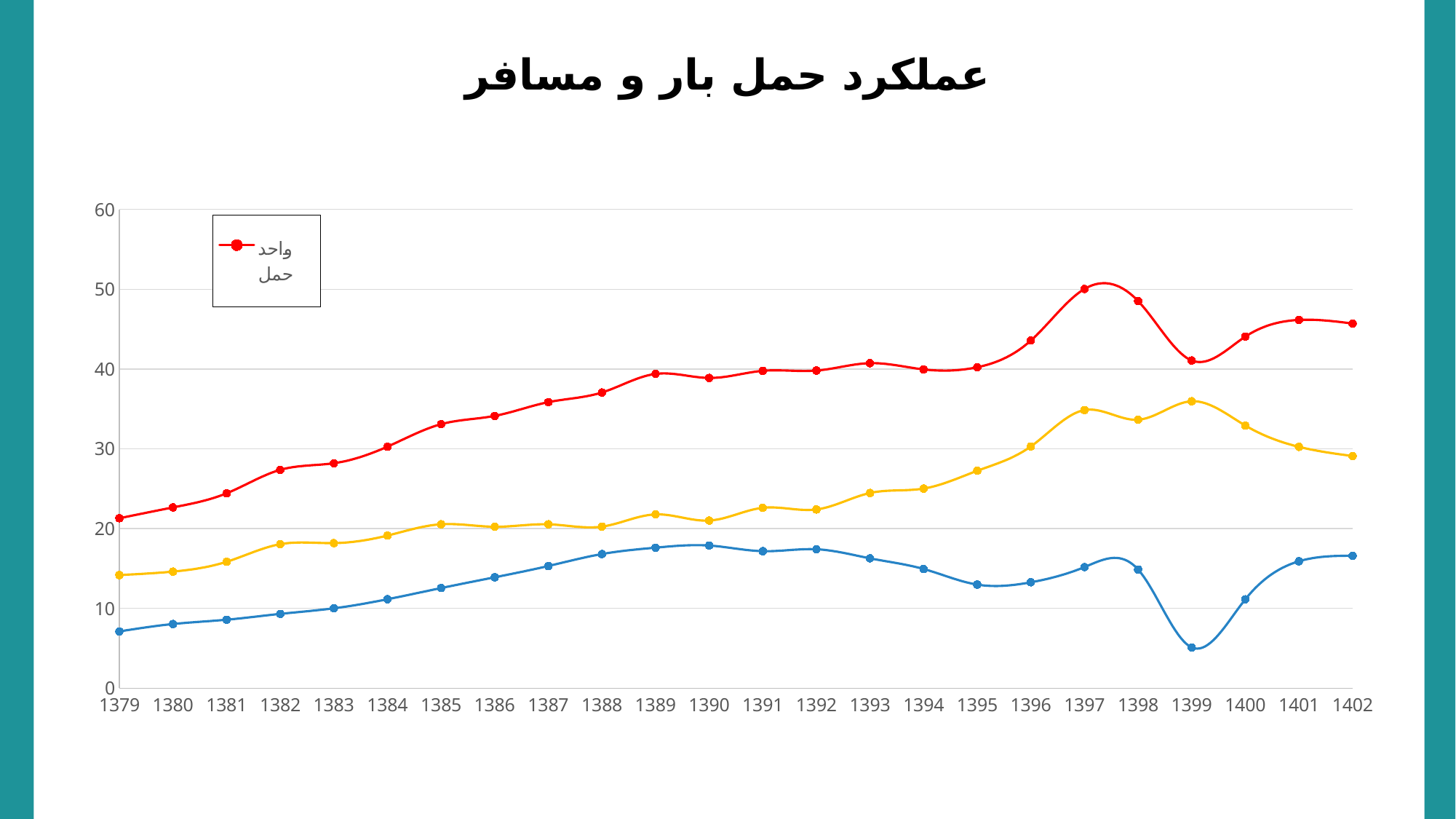
What is the title of the chart? عملکرد حمل بار و مسافر Is the value of the red series (واحد حمل) in 1397 greater or less than 40? greater Is the value of the blue series in 1399 greater or less than 10? less How many years are shown along the x axis? 24 In 1399, which series has the larger value, the red series or the blue series? red series In which year does the red series (واحد حمل) reach its highest value? 1397 How many series does the legend list? 1 Is the value of the yellow series in 1399 greater or less than 30? greater In which year is the red series (واحد حمل) at its lowest value? 1379 Does the red series (واحد حمل) rise or fall from 1379 to 1389? rise What kind of chart is shown on the slide? line chart In which year does the blue series reach its lowest value? 1399